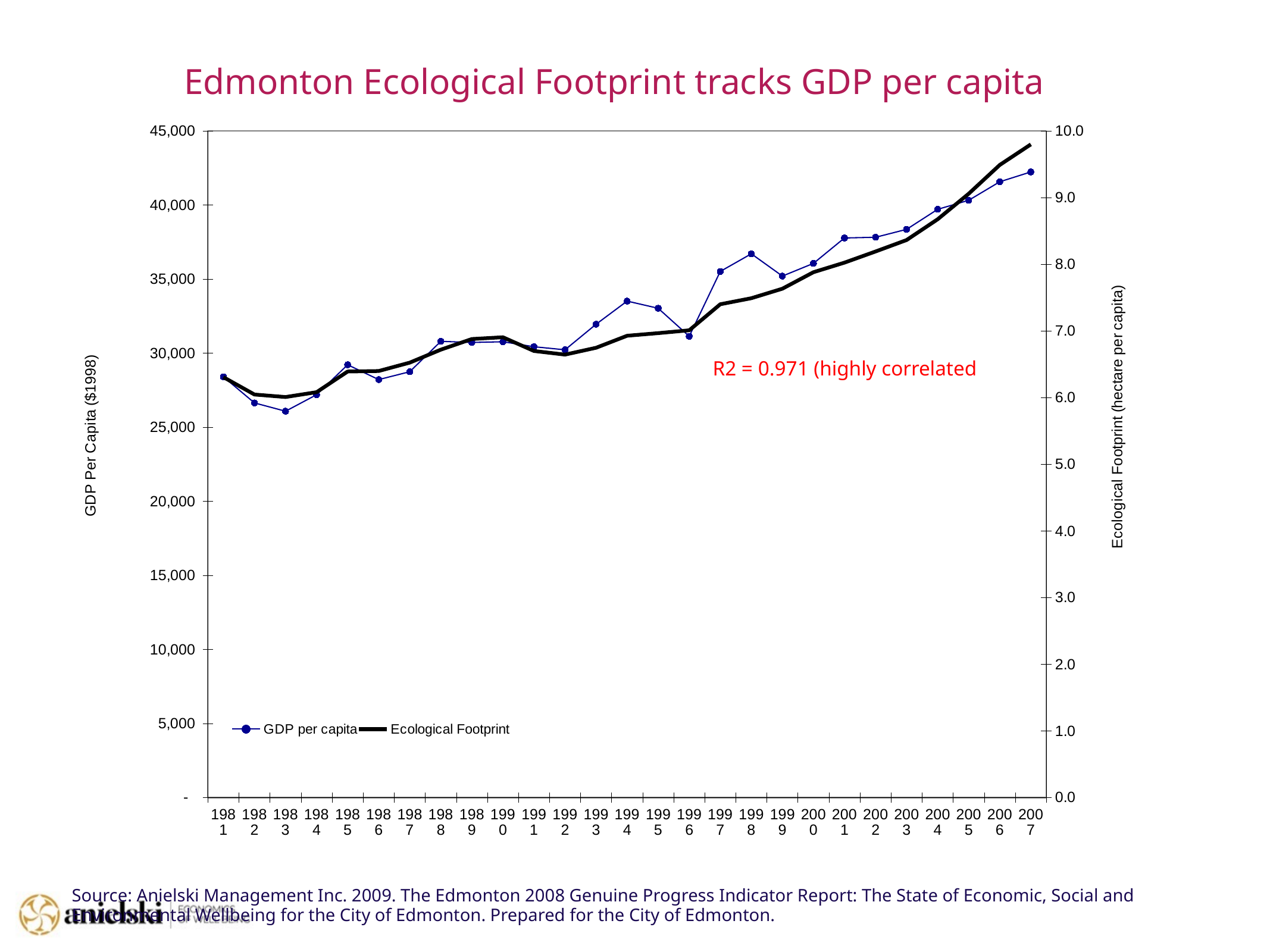
Overall, does the Ecological Footprint rise or fall from 1981 to 2007? Rise Which series is drawn as a thick black line? Ecological Footprint How many series does the legend list? 2 Is the GDP per capita value for 2007 greater or less than 40,000? greater Which year has the higher GDP per capita, 1998 or 1999? 1998 What kind of chart is shown on the slide? Line chart Is the Ecological Footprint value for 2007 greater or less than 9.0? greater What R2 value is annotated on the chart? R2 = 0.971 How many years are plotted along the x axis? 27 In which year is GDP per capita highest? 2007 Is the Ecological Footprint value for 1981 greater or less than 7.0? less